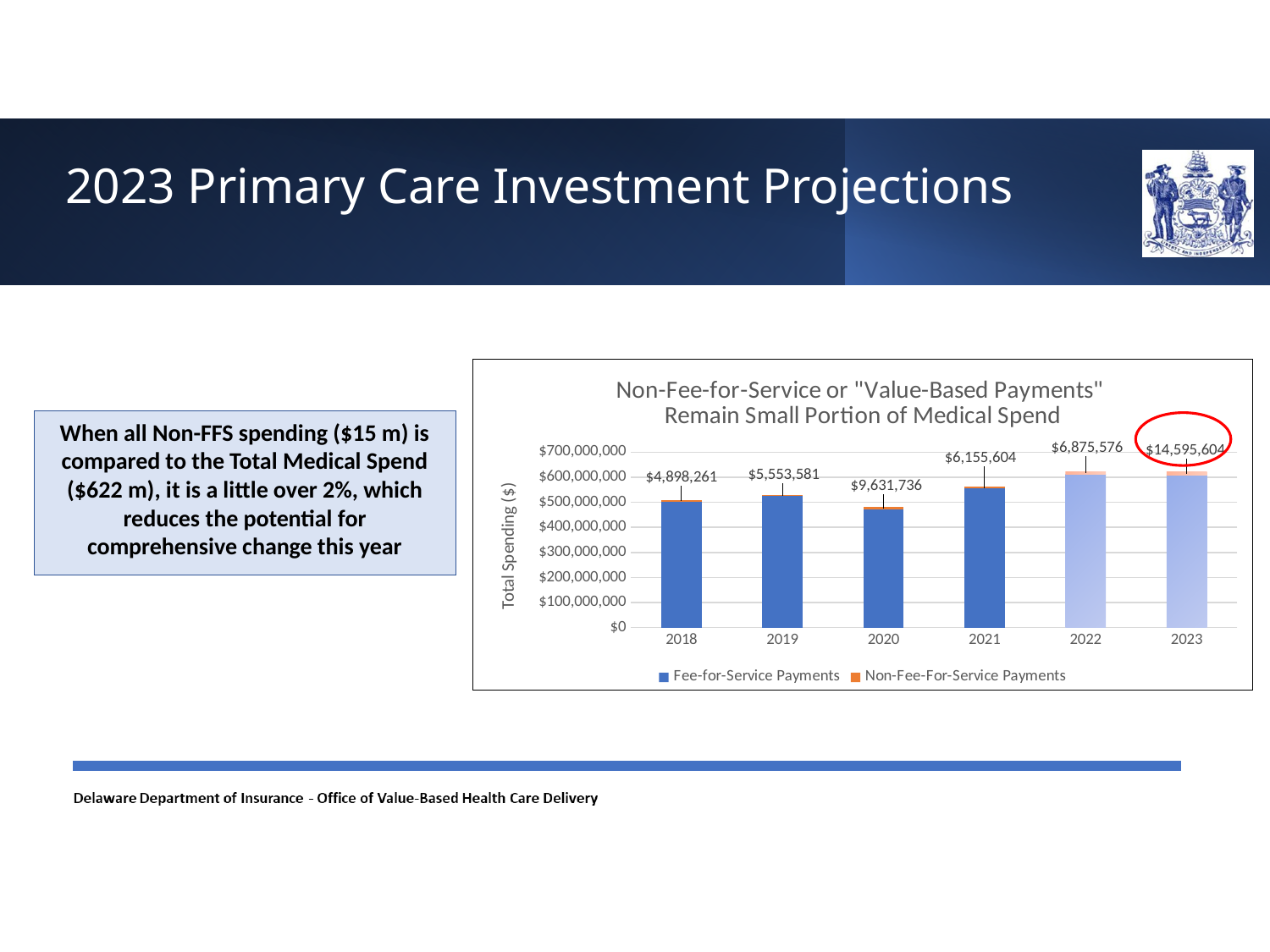
Is the total spending bar for 2020 greater or less than $500,000,000? less What is the Non-Fee-For-Service Payments value for 2018? $4,898,261 What kind of chart is shown on the slide? Stacked bar chart Which year has the lowest Non-Fee-For-Service Payments value? 2018 What is the Non-Fee-For-Service Payments value for 2023? $14,595,604 How many years are shown on the x axis? 6 How many series does the legend list? 2 Which year has the highest Non-Fee-For-Service Payments value? 2023 What is the Non-Fee-For-Service Payments value for 2020? $9,631,736 What is the difference between the Non-Fee-For-Service Payments values for 2023 and 2022? $7,720,028 Which year has the larger Non-Fee-For-Service Payments value, 2020 or 2021? 2020 Is the total spending bar for 2021 greater or less than $500,000,000? greater